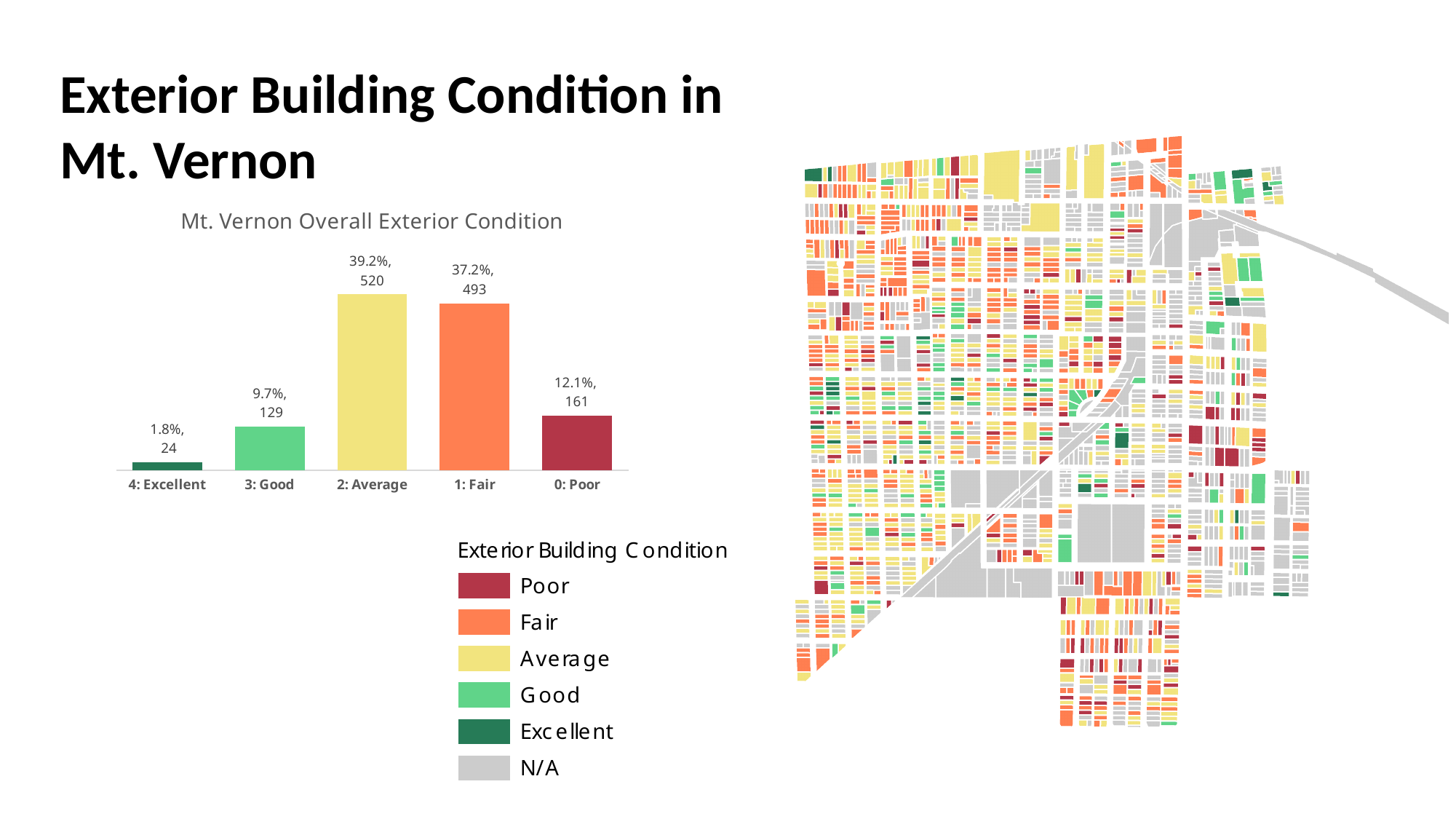
What is the title of the chart on the slide? Mt. Vernon Overall Exterior Condition What is the count for the "2: Average" category in the Mt. Vernon Overall Exterior Condition chart? 520 Which category has the lowest count in the chart? 4: Excellent What is the difference in count between the "2: Average" and "1: Fair" categories? 27 Which category has the highest count in the Mt. Vernon Overall Exterior Condition chart? 2: Average What percentage is shown for the "4: Excellent" category? 1.8% How many buildings are in the "0: Poor" category? 161 Which has a larger count, "3: Good" or "0: Poor"? 0: Poor What is the difference in count between the "0: Poor" and "3: Good" categories? 32 What type of chart is the Mt. Vernon Overall Exterior Condition chart? Bar chart How many categories are shown in the Mt. Vernon Overall Exterior Condition chart? 5 What percentage of buildings are in the "1: Fair" category? 37.2%